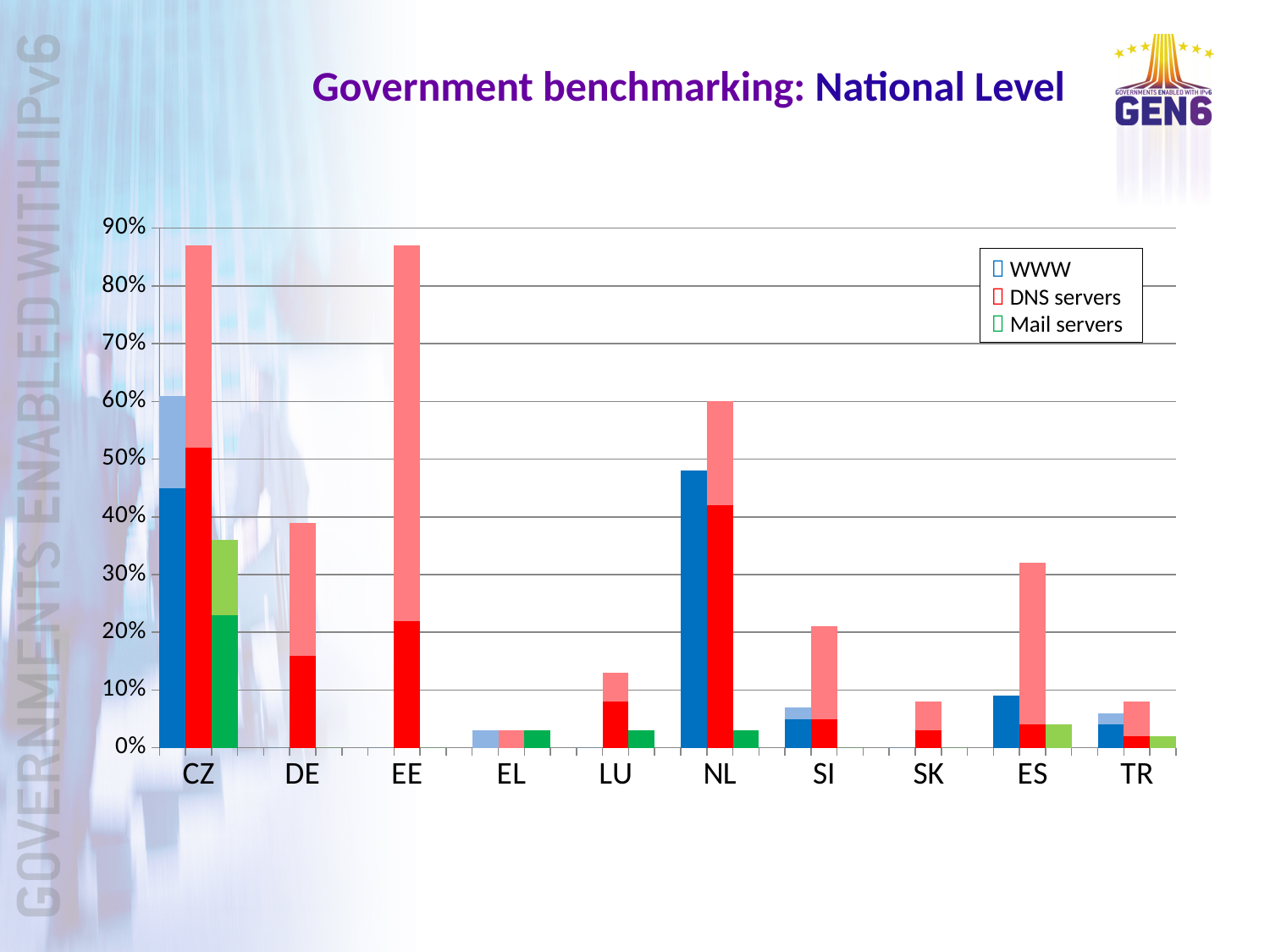
Which is larger, the DNS servers value for DE or the DNS servers value for LU? DE What kind of chart is shown on the slide? bar chart Is the Mail servers value for LU greater or less than 10%? less Which country has the highest Mail servers value? CZ How many series does the chart's legend list? 3 How many countries (categories) are shown on the x axis of the chart? 10 Is the DNS servers value for SK greater or less than 10%? less Is the WWW value for NL greater or less than 40%? greater Which series are listed in the chart's legend? WWW, DNS servers, Mail servers Which is larger, the WWW value for NL or the WWW value for ES? NL What is the title of the chart slide? Government benchmarking: National Level